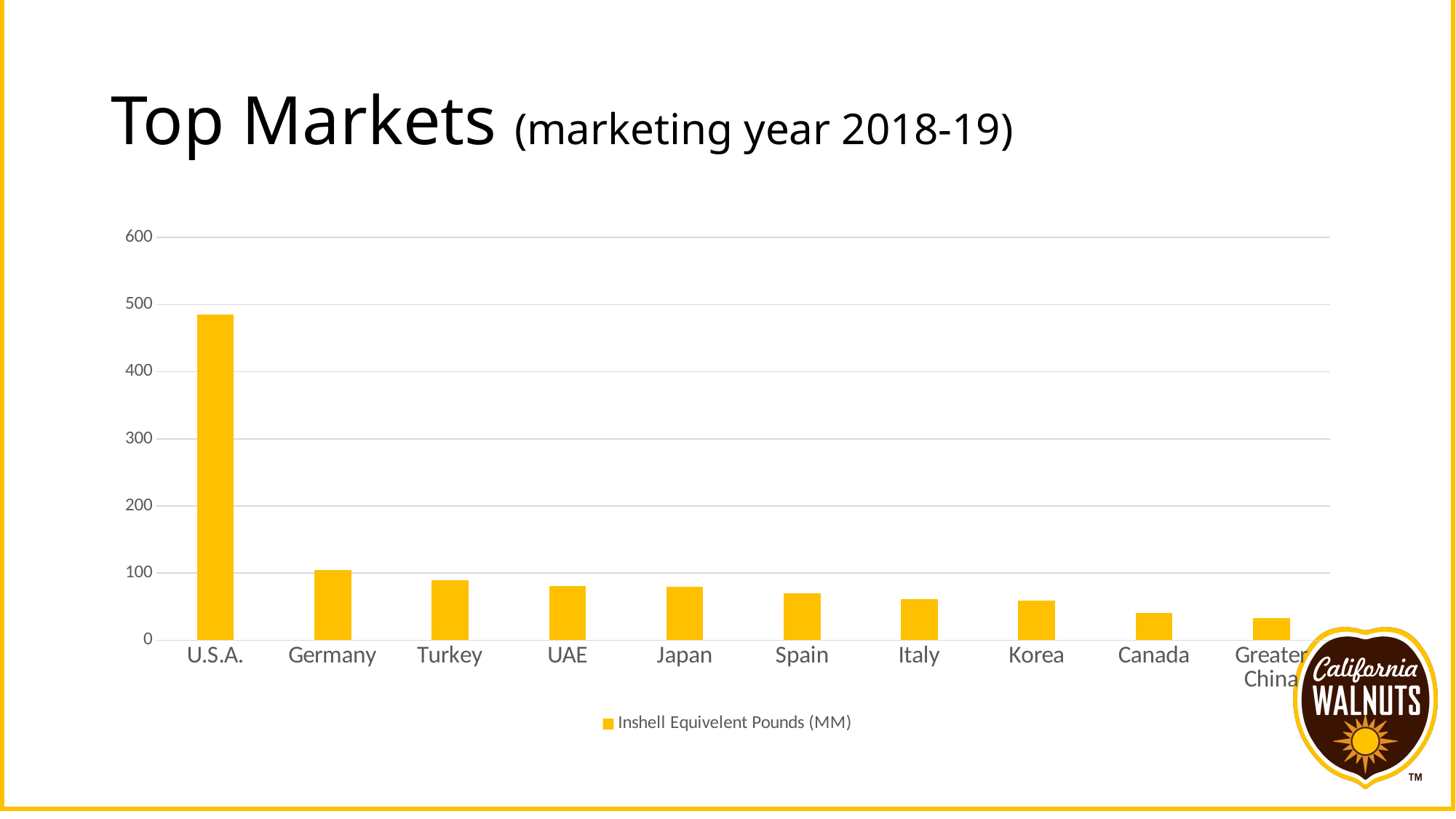
Which is larger, the value for Germany or the value for Turkey? Germany Which market has the highest value in the Top Markets chart? U.S.A. What kind of chart is shown on the slide? Bar chart How many series does the legend list? 1 Which is larger, the value for U.S.A. or the value for Germany? U.S.A. How many markets are shown in the chart? 10 Which market has the lowest value in the Top Markets chart? Greater China Is the value for Germany greater or less than 200? less What is the name of the series shown in the legend? Inshell Equivelent Pounds (MM) Is the value for U.S.A. greater or less than 400? greater Is the value for Canada greater or less than 100? less